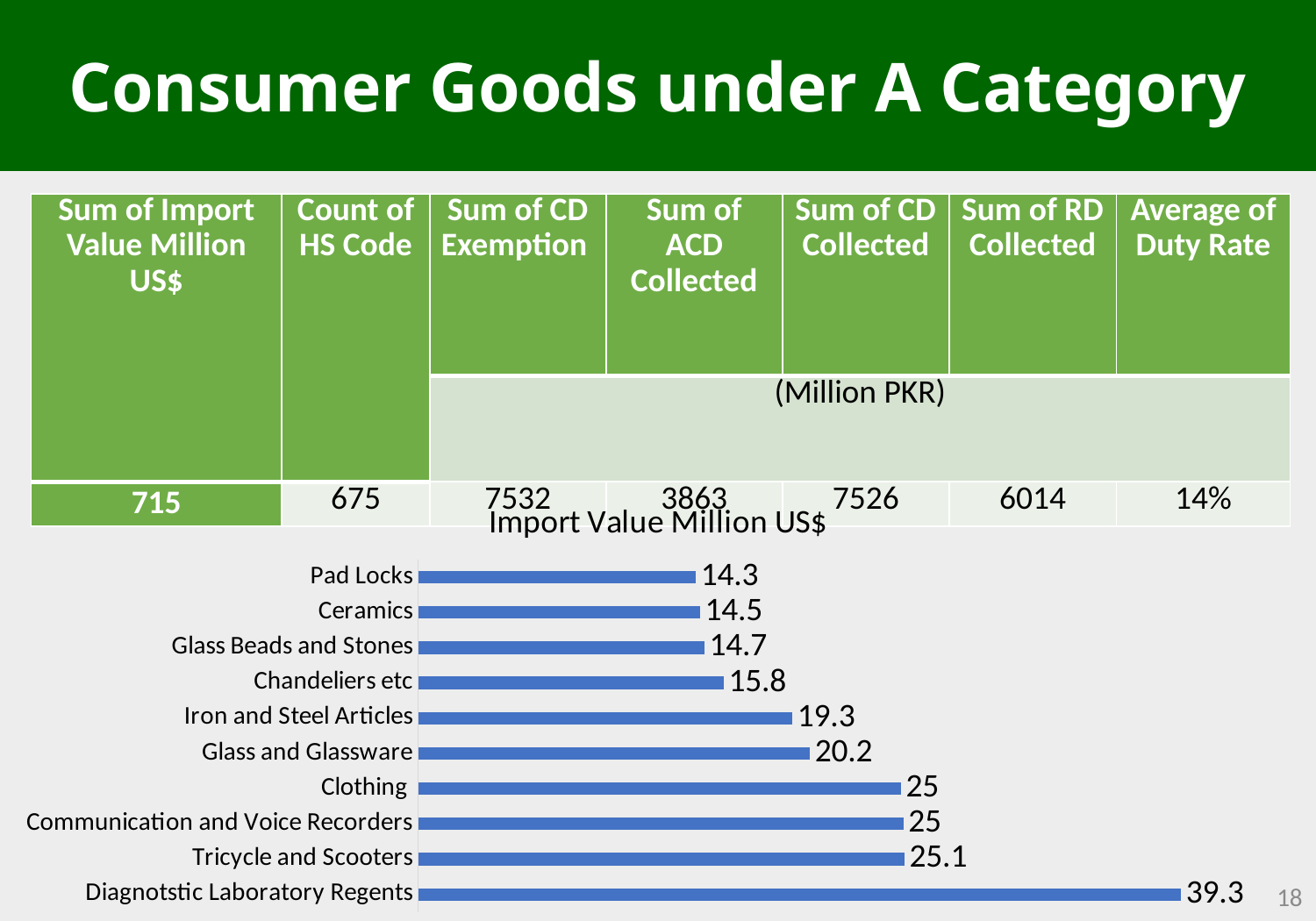
What is the import value for Glass and Glassware? 20.2 Which has a larger import value, Chandeliers etc or Iron and Steel Articles? Iron and Steel Articles What is the title of the chart? Import Value Million US$ Which category has the lowest import value? Pad Locks What is the difference between the import values of Glass and Glassware and Iron and Steel Articles? 0.9 How many categories are shown in the chart? 10 What is the difference between the import values of Diagnotstic Laboratory Regents and Tricycle and Scooters? 14.2 Which category has the highest import value? Diagnotstic Laboratory Regents What is the import value for Ceramics? 14.5 What is the import value for Pad Locks? 14.3 What kind of chart is shown on the slide? Bar chart What is the import value for Tricycle and Scooters? 25.1